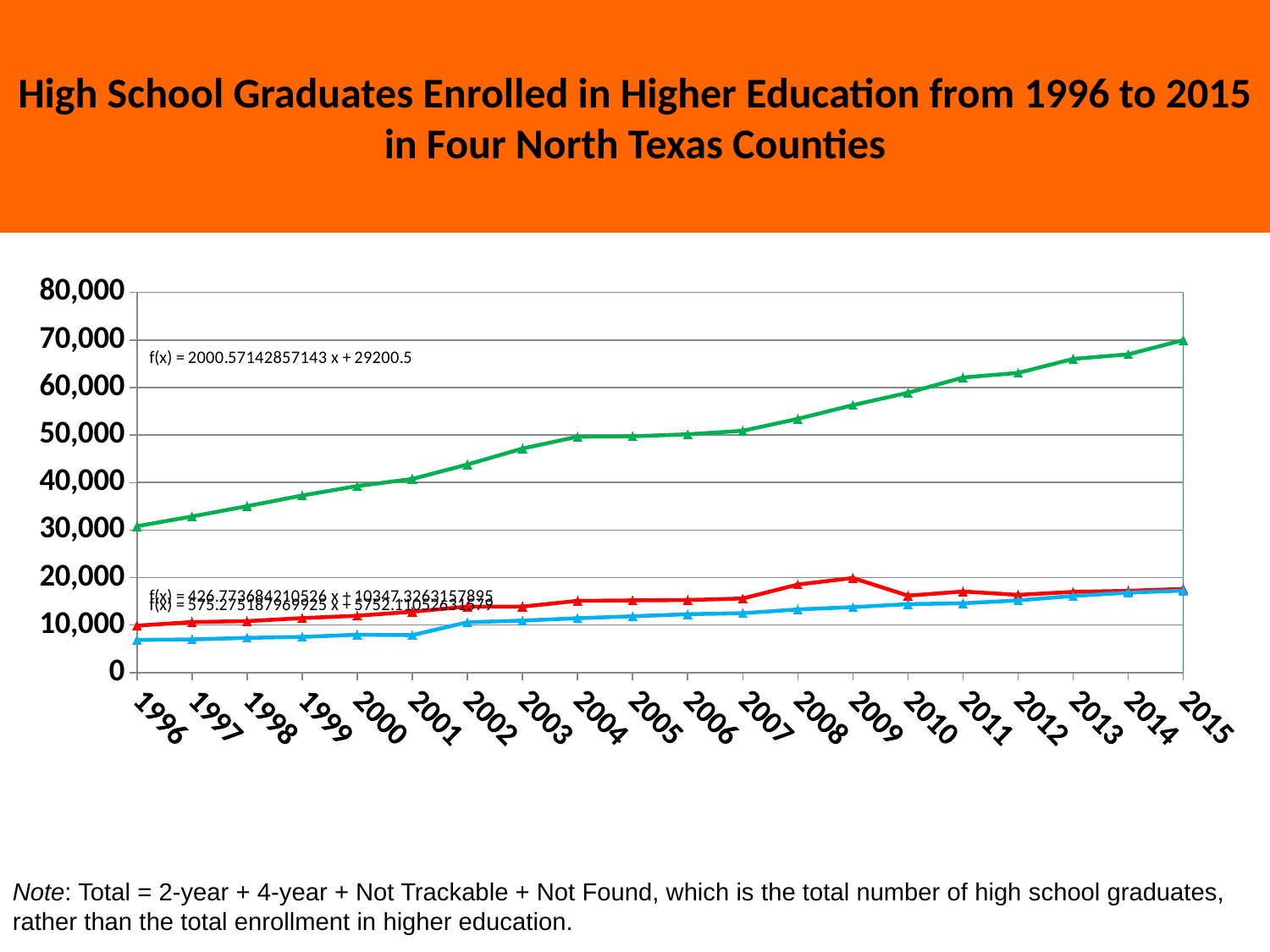
What is the title of the chart? High School Graduates Enrolled in Higher Education from 1996 to 2015 in Four North Texas Counties Is the value of the blue line in 1996 greater or less than 10,000? less Does the green line rise or fall from 1996 to 2015? rise In 2010, which line has the larger value, the green line or the red line? green line In which year does the green line reach its highest value? 2015 What kind of chart is shown on the slide? line chart Is the value of the green line in 2008 greater or less than 50,000? greater How many lines are plotted on the chart? 3 Is the value of the green line in 2011 greater or less than 60,000? greater In which year does the red line reach its highest value? 2009 How many years are plotted along the x axis? 20 In which year is the green line at its lowest value? 1996